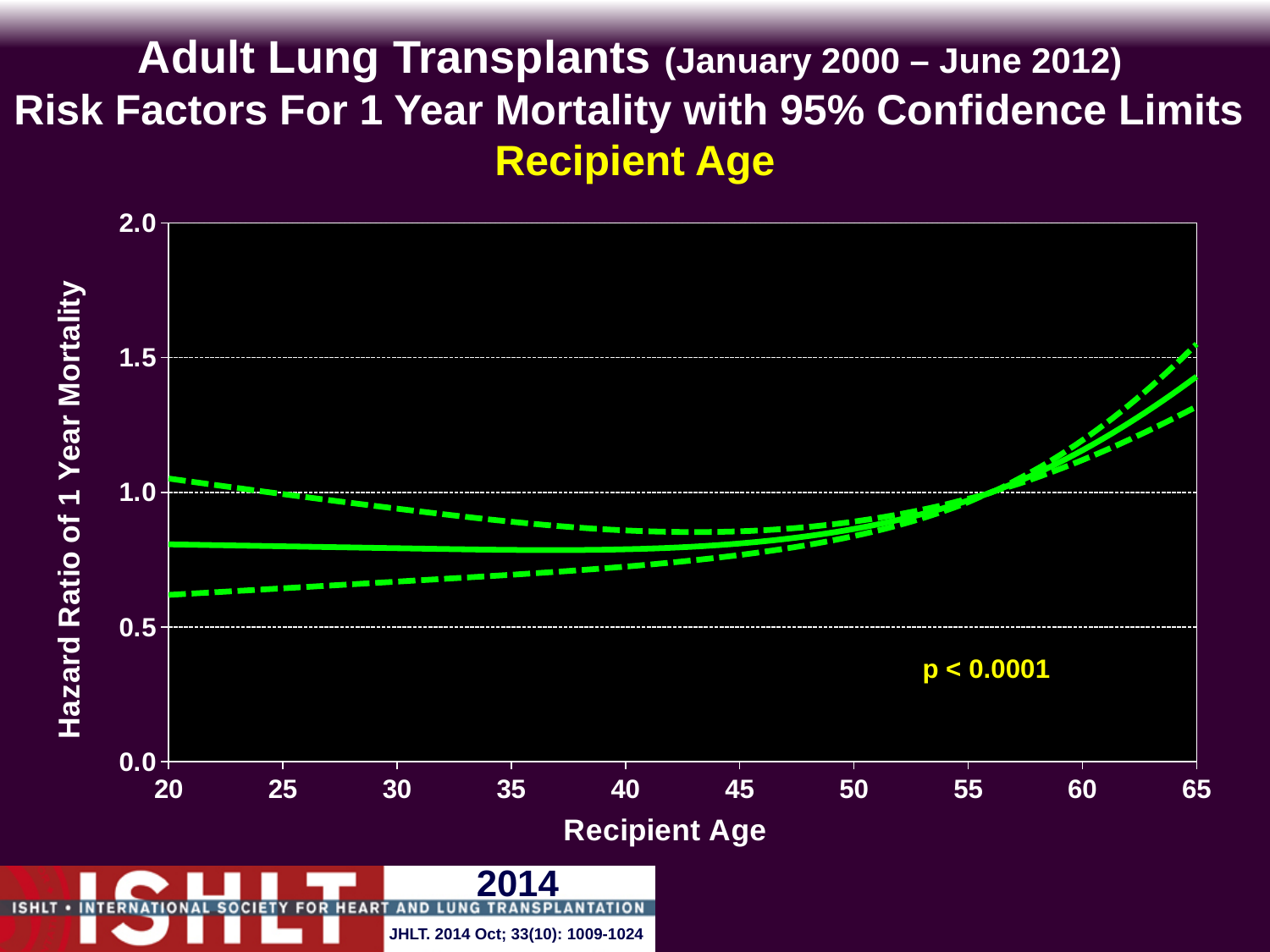
Is the hazard ratio of 1 year mortality (solid line) at recipient age 65 greater or less than 1.0? greater What p-value is printed on the chart? p < 0.0001 How many lines are plotted on the chart (including the confidence limits)? 3 Is the lower 95% confidence limit (lower dashed line) at recipient age 20 greater or less than 0.5? greater Is the hazard ratio of 1 year mortality (solid line) at recipient age 65 greater or less than 1.5? less How many tick labels are shown on the Recipient Age (x) axis? 10 Which has the larger hazard ratio of 1 year mortality: recipient age 20 or recipient age 65? recipient age 65 What is the title of the chart's y axis? Hazard Ratio of 1 Year Mortality Between recipient age 45 and recipient age 65, does the hazard ratio of 1 year mortality rise or fall? rise What kind of chart is shown on the slide? line chart